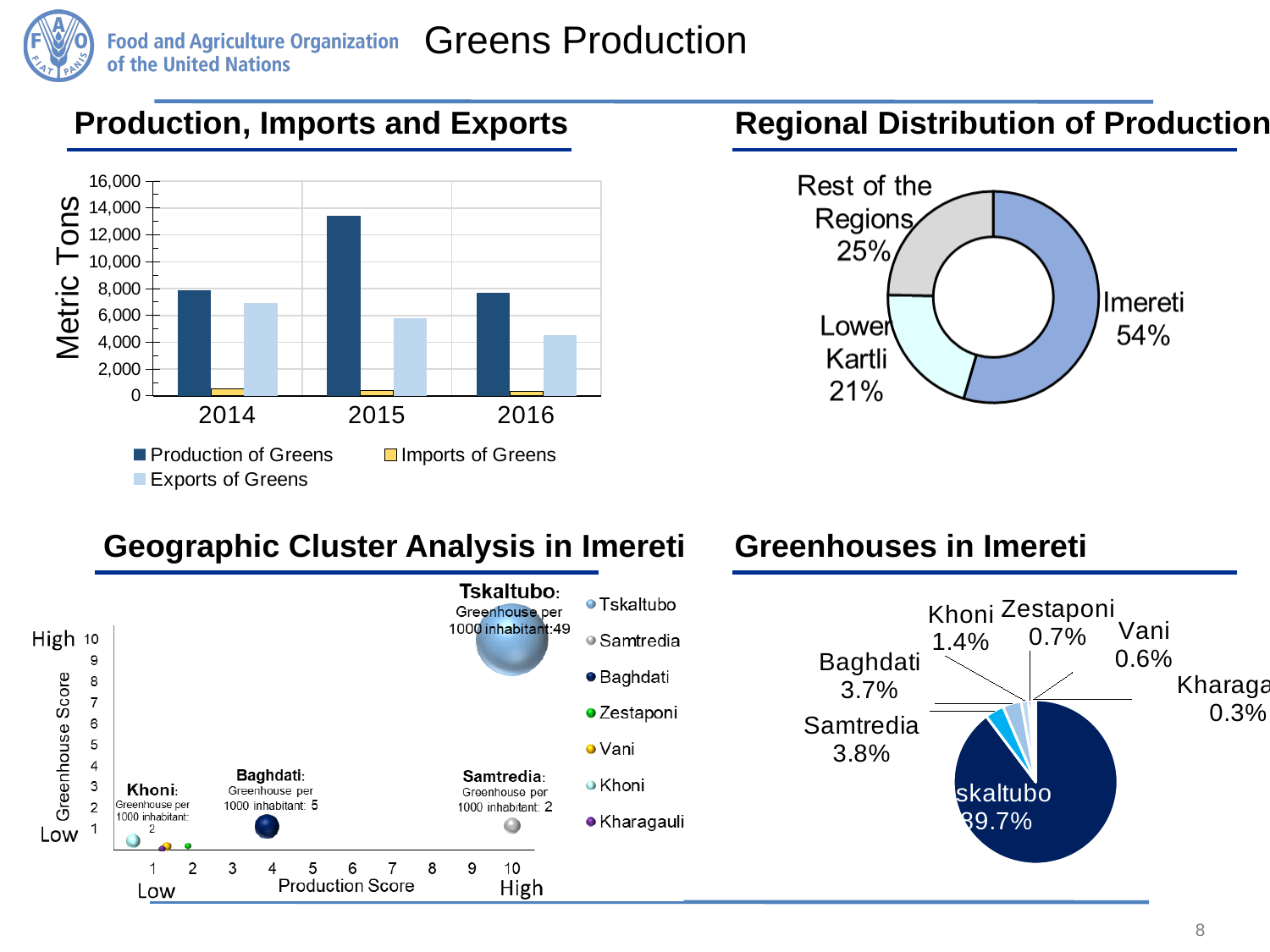
In the Greenhouses in Imereti chart, which has the larger share, Samtredia or Baghdati? Samtredia In the Production, Imports and Exports chart, is the value for Exports of Greens in 2016 greater or less than 6,000? less How many series does the legend of the Production, Imports and Exports chart list? 3 What type of chart is the Production, Imports and Exports chart? Bar chart In the Regional Distribution of Production chart, which region has the largest share? Imereti In the Geographic Cluster Analysis in Imereti chart, how many greenhouses per 1000 inhabitants does Tskaltubo have? 49 In the Production, Imports and Exports chart, which year has the highest Production of Greens? 2015 In the Greenhouses in Imereti chart, what share does Tskaltubo have? 89.7% In the Regional Distribution of Production chart, what share of production does Imereti account for? 54% In the Regional Distribution of Production chart, how many percentage points larger is Imereti's share than that of the Rest of the Regions? 29 percentage points In the Regional Distribution of Production chart, what is the share for Lower Kartli? 21% In the Production, Imports and Exports chart, is the value for Production of Greens in 2015 greater or less than 12,000? greater